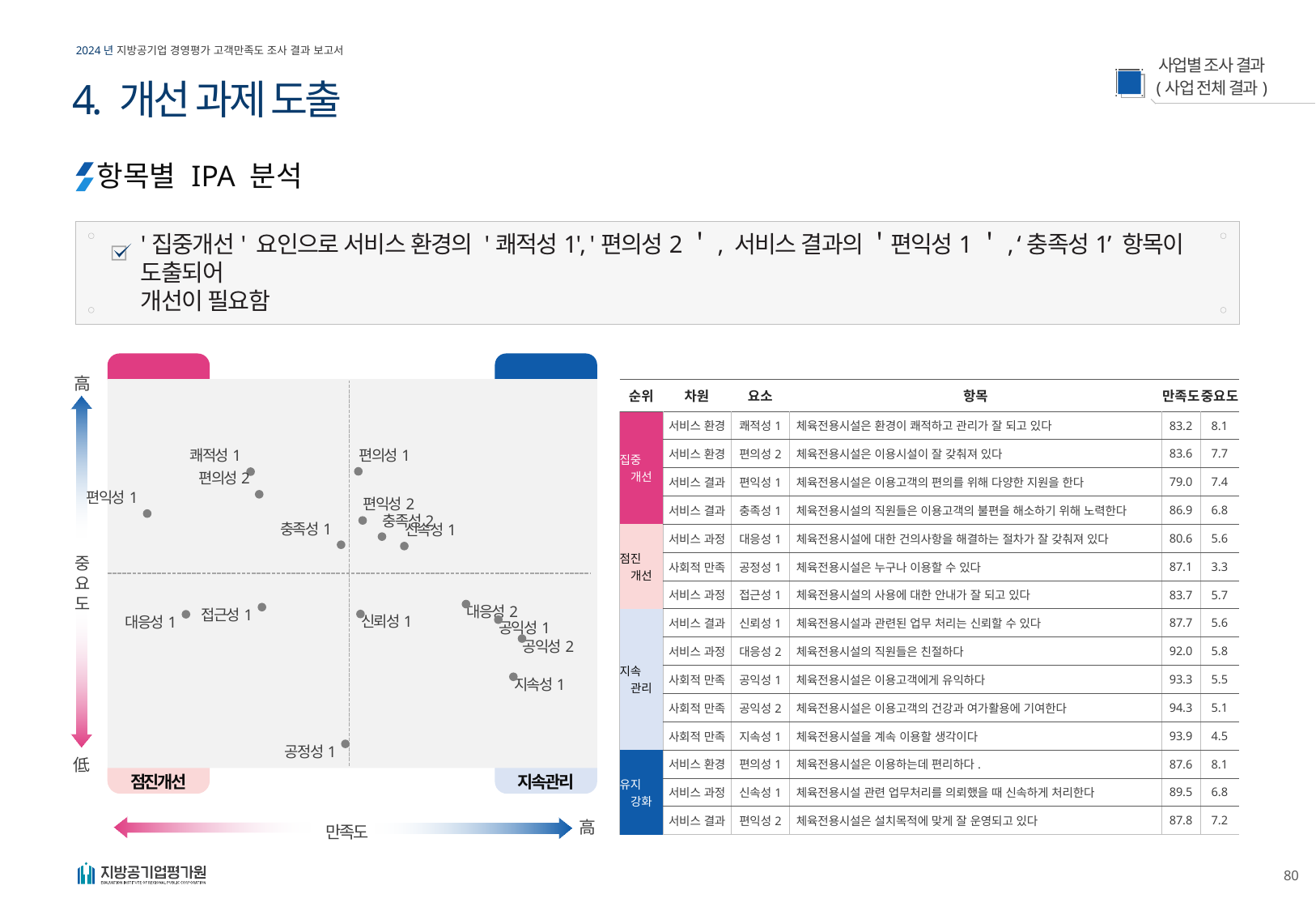
In the IPA scatter chart, which point has higher satisfaction (만족도): 지속성 1 or 편익성 1? 지속성 1 In the IPA scatter chart, which point has the lowest importance (중요도)? 공정성 1 According to the table on the slide, what is the 만족도 value for 쾌적성 1? 83.2 In the IPA scatter chart, what is the label of the horizontal axis? 만족도 In the IPA scatter chart, what label is shown for the bottom-right quadrant? 지속관리 According to the table on the slide, which item has the highest 만족도 value? 공익성 2 How many labelled points are plotted in the IPA scatter chart? 16 According to the table on the slide, what is the 중요도 value for 충족성 1? 6.8 What kind of chart is shown on the left of the slide? scatter chart According to the table on the slide, what is the difference in 만족도 between 공익성 2 and 편익성 1? 15.3 In the IPA scatter chart, which point has higher importance (중요도): 쾌적성 1 or 공정성 1? 쾌적성 1 In the IPA scatter chart, which point has the lowest satisfaction (만족도)? 편익성 1